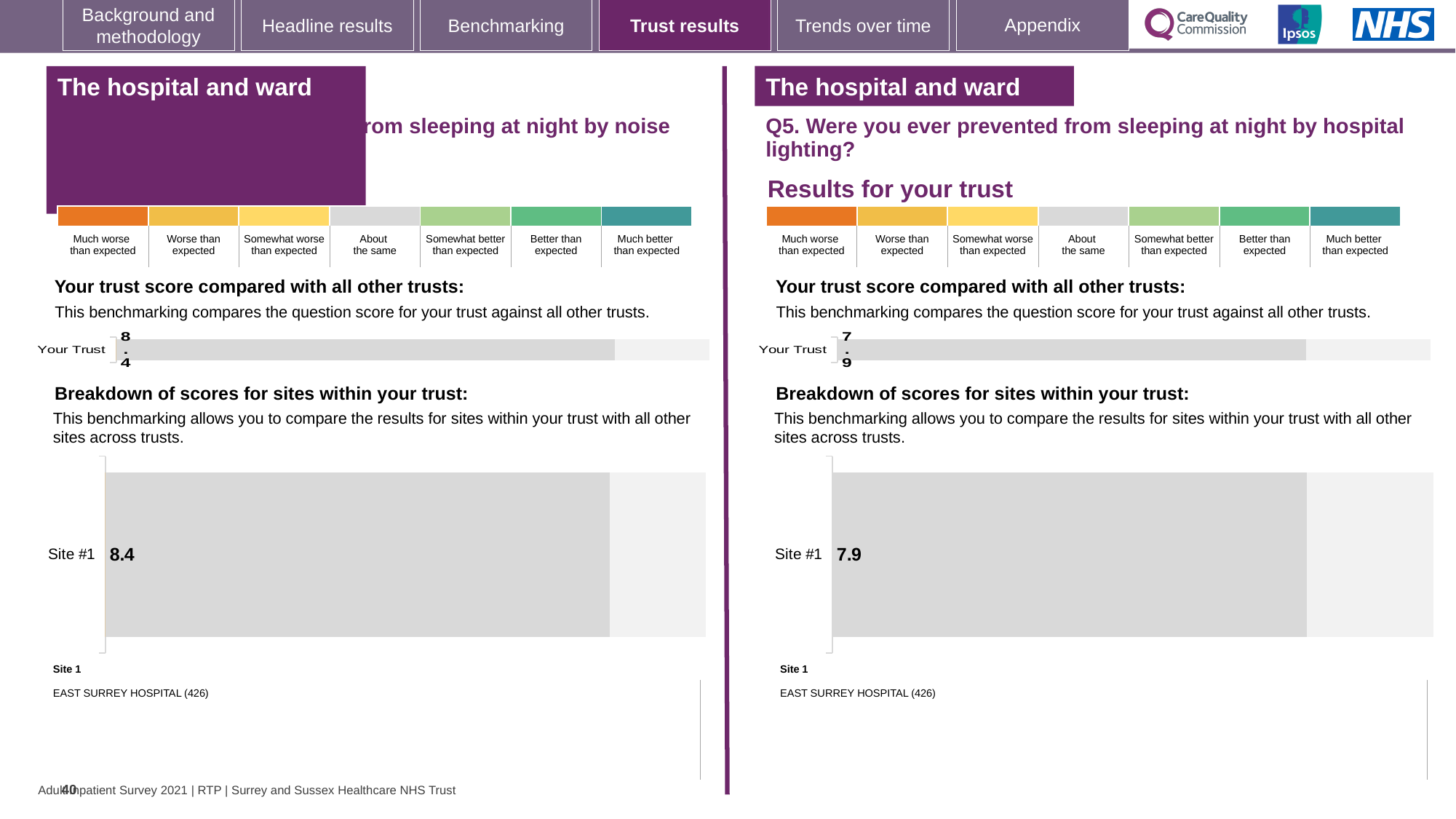
What is the difference between the Your Trust score on the left-hand chart (noise) and the Your Trust score on the right-hand chart (Q5, hospital lighting)? 0.5 On the right-hand chart for Q5, is the Site #1 score greater or less than the Site #1 score on the left-hand chart about noise? less Which hospital is listed as Site 1 beneath the breakdown charts? EAST SURREY HOSPITAL (426) How many sites are shown in the left-hand breakdown chart about noise at night? 1 What kind of chart is used to show the Your Trust score on the right-hand side for Q5? Bar chart Which has the higher Your Trust score: the left-hand chart about noise at night or the right-hand chart for Q5 about hospital lighting? The left-hand chart about noise at night On the left-hand breakdown chart about noise at night, what is the score for Site #1? 8.4 On the right-hand breakdown chart for Q5 (hospital lighting), what is the score for Site #1? 7.9 On the right-hand chart for Q5 (hospital lighting), what is the score shown for Your Trust? 7.9 How many rating bands are shown in the colour key above the Q5 chart on the right-hand side? 7 How many sites are shown in the right-hand breakdown chart for Q5 (hospital lighting)? 1 On the left-hand chart about being prevented from sleeping by noise, what is the score shown for Your Trust? 8.4